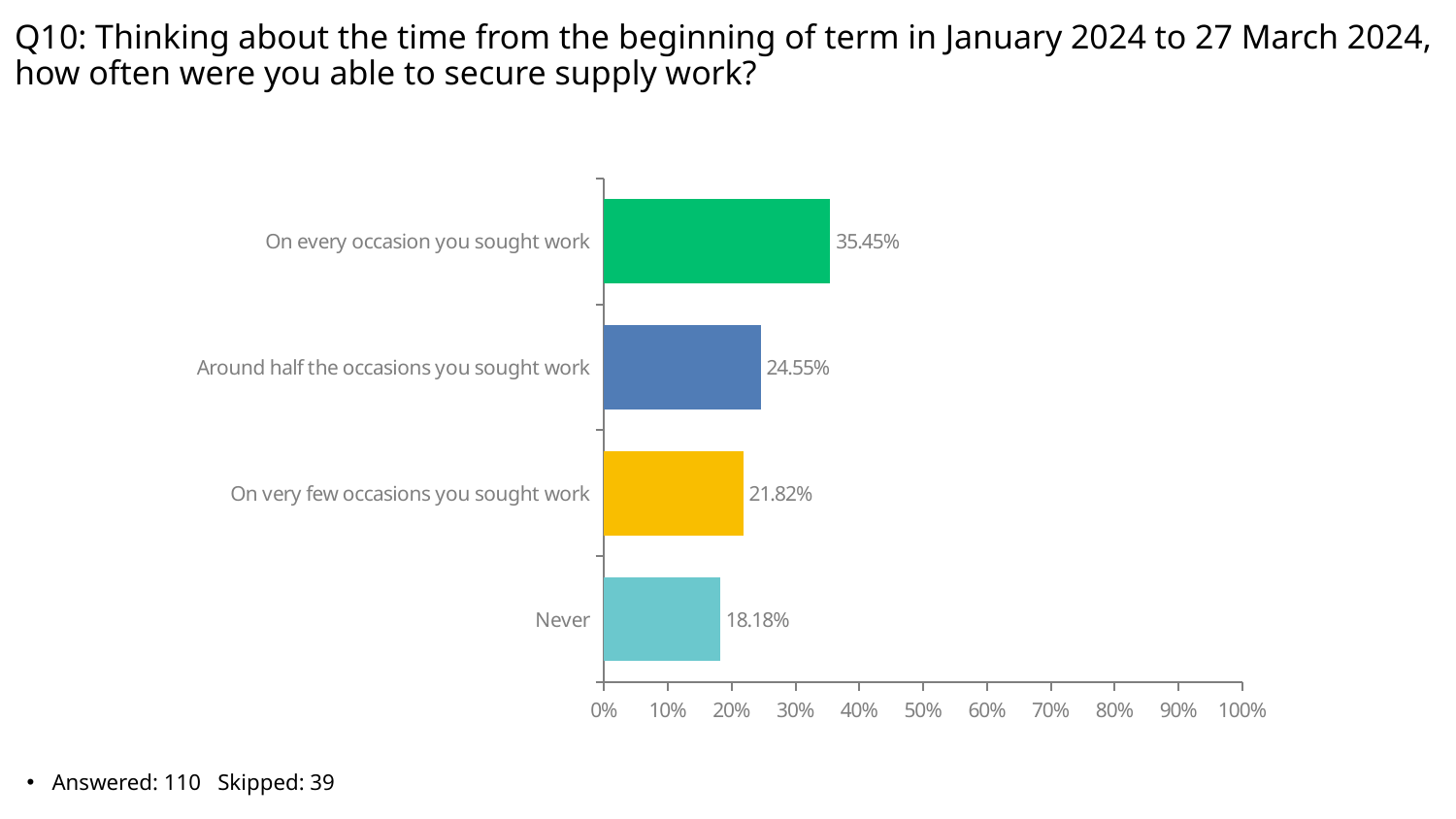
What type of chart is shown on the slide? Bar chart What percentage of respondents said they were able to secure supply work on every occasion they sought work? 35.45% What is the difference in percentage points between 'On every occasion you sought work' and 'Never'? 17.27 What is the value for 'On very few occasions you sought work'? 21.82% Which is larger: the value for 'Around half the occasions you sought work' or 'On very few occasions you sought work'? Around half the occasions you sought work What is the value for 'Around half the occasions you sought work'? 24.55% What colour is the bar for 'Never'? Light blue (teal) Which category has the lowest percentage? Never What percentage of respondents answered 'Never'? 18.18% How many categories are shown in the chart? 4 Is the value for 'On every occasion you sought work' greater or less than 30%? greater Which category has the highest percentage? On every occasion you sought work